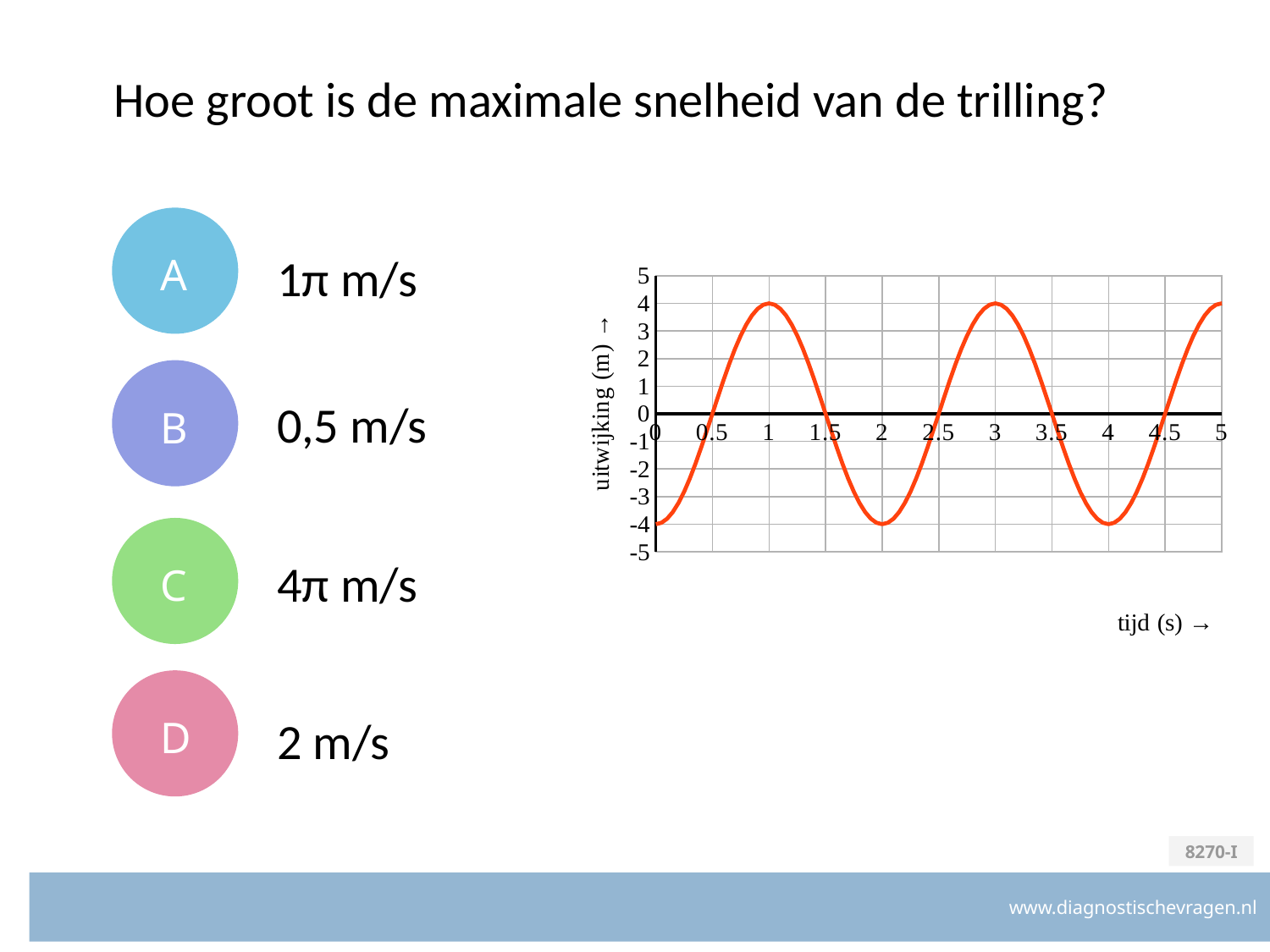
What kind of chart is shown on the slide? line chart Does the curve rise or fall between tijd = 0 s and tijd = 1 s? rise Is the uitwijking at tijd = 1 s greater or less than the uitwijking at tijd = 2 s? greater What is the minimum value of uitwijking reached by the curve? -4 What is the uitwijking at tijd = 2.5 s? 0 What is the uitwijking at tijd = 2 s? -4 What is the difference between the uitwijking at tijd = 3 s and at tijd = 4 s? 8 What is the maximum value of uitwijking reached by the curve? 4 What is the label of the vertical axis of the chart? uitwijking (m) What is the label of the horizontal axis of the chart? tijd (s) What is the uitwijking at tijd = 0 s? -4 What is the uitwijking at tijd = 1 s? 4